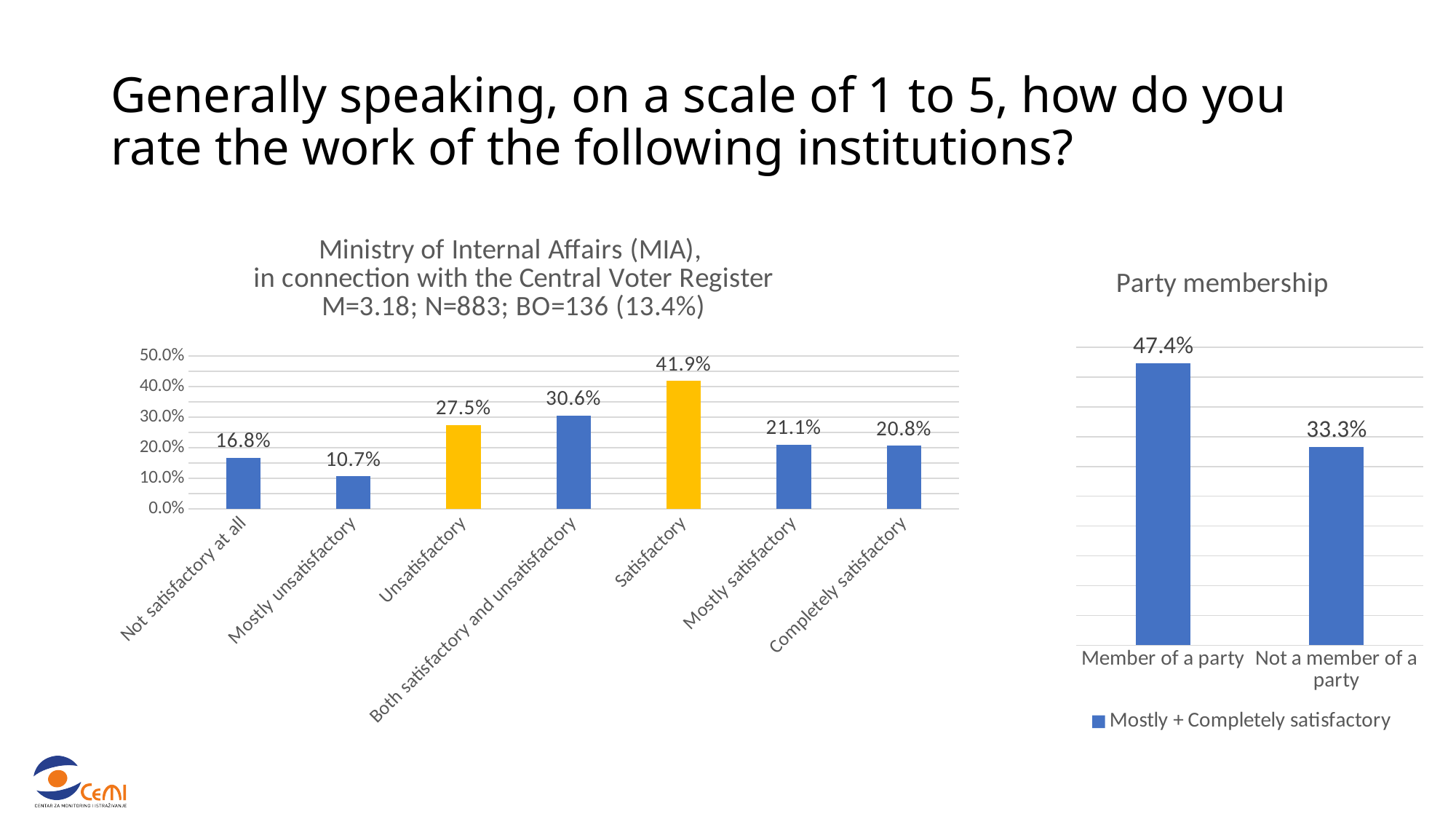
How many categories are shown in the Ministry of Internal Affairs (MIA) chart? 7 In the Ministry of Internal Affairs (MIA) chart, what is the value for "Mostly unsatisfactory"? 10.7% In the Ministry of Internal Affairs (MIA) chart, which category has the lowest value? Mostly unsatisfactory How many series does the legend of the Party membership chart list? 1 What type of chart is the Party membership chart? Bar chart In the Ministry of Internal Affairs (MIA) chart, which category has the highest value? Satisfactory In the Ministry of Internal Affairs (MIA) chart, what is the difference between "Satisfactory" and "Unsatisfactory"? 14.4% In the Party membership chart, what is the difference between "Member of a party" and "Not a member of a party"? 14.1% In the Party membership chart, what is the value for "Member of a party"? 47.4% In the Ministry of Internal Affairs (MIA) chart, which two categories have bars coloured yellow? Unsatisfactory and Satisfactory In the Ministry of Internal Affairs (MIA) chart, what is the value for "Satisfactory"? 41.9% In the Ministry of Internal Affairs (MIA) chart, which is larger: "Not satisfactory at all" or "Both satisfactory and unsatisfactory"? Both satisfactory and unsatisfactory